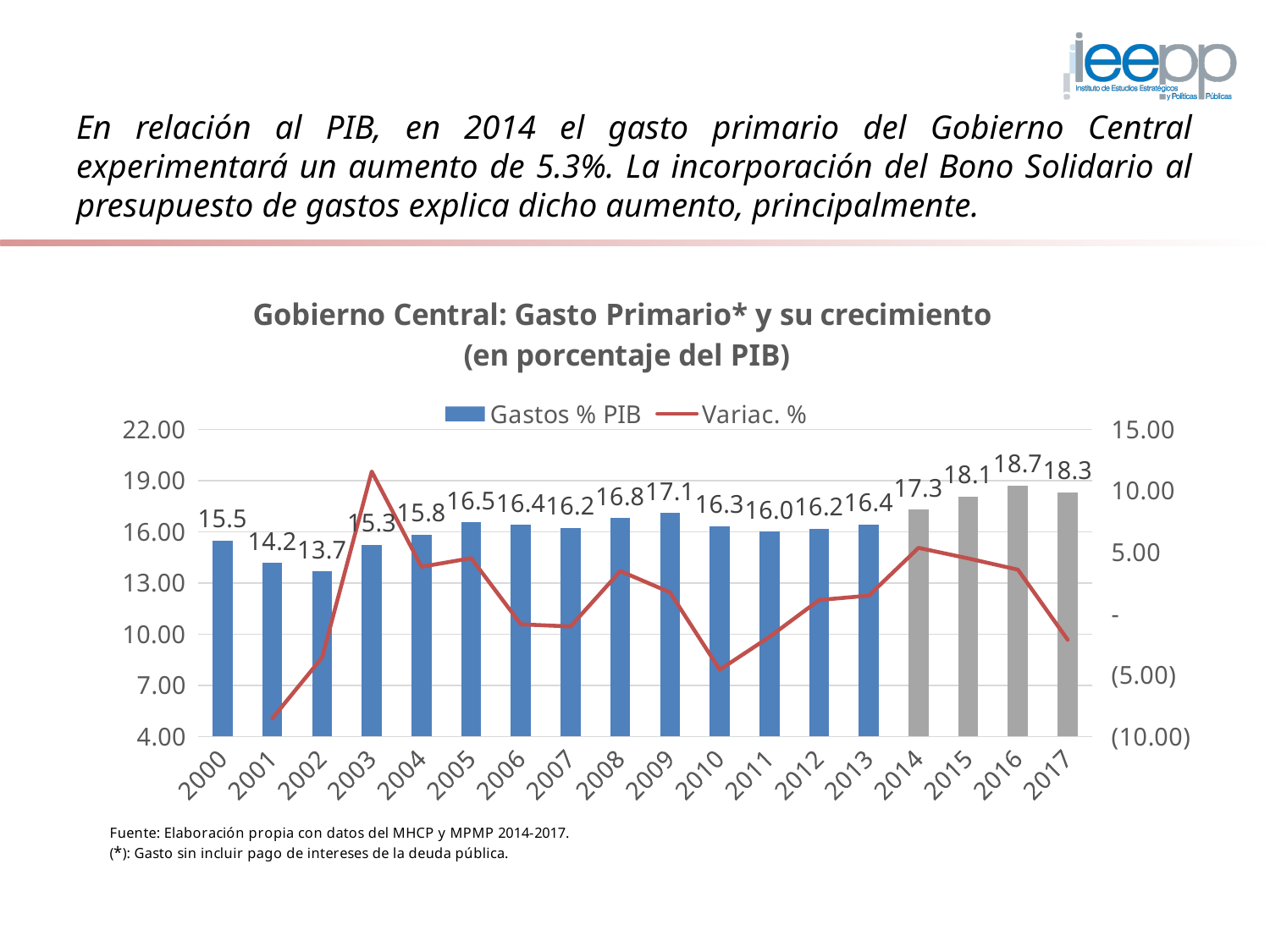
How many series does the legend list? 2 What is the Gastos % PIB value for 2002? 13.7 What is the difference between the Gastos % PIB values for 2017 and 2013? 1.9 Is the Variac. % value for 2010 greater or less than 0? less Which year has the highest Gastos % PIB value? 2016 Which year has the lowest Gastos % PIB value? 2002 How many years are shown on the x axis? 18 Which is larger, the Gastos % PIB value for 2005 or for 2010? 2005 Is the Variac. % value for 2003 greater or less than 10.00? greater What is the title of the chart? Gobierno Central: Gasto Primario* y su crecimiento (en porcentaje del PIB) What is the Gastos % PIB value for 2014? 17.3 What is the Gastos % PIB value for 2009? 17.1